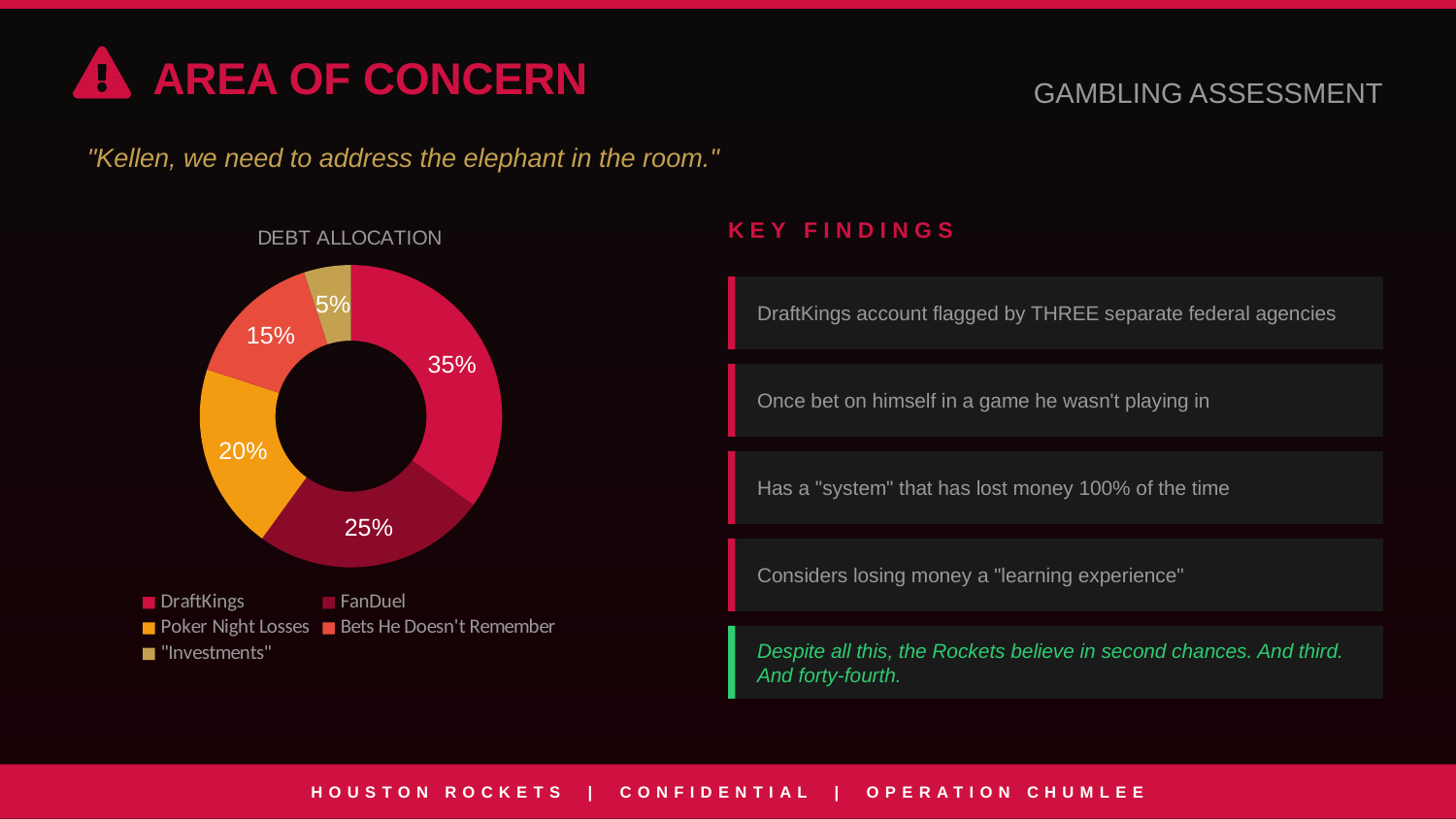
What percentage of the debt allocation is labelled "Investments"? 5% What type of chart is shown under the title "DEBT ALLOCATION"? Doughnut chart What percentage is shown for Bets He Doesn't Remember? 15% What percentage of the debt allocation is attributed to FanDuel? 25% Which is larger in the debt allocation: Poker Night Losses or Bets He Doesn't Remember? Poker Night Losses What share of the debt allocation is Poker Night Losses? 20% What is the title of the chart on the slide? DEBT ALLOCATION How many categories does the debt allocation chart show? 5 What percentage of the debt allocation is attributed to DraftKings? 35% Which category has the largest share of the debt allocation? DraftKings Which category has the smallest share of the debt allocation? "Investments" What is the difference in percentage points between DraftKings and FanDuel? 10